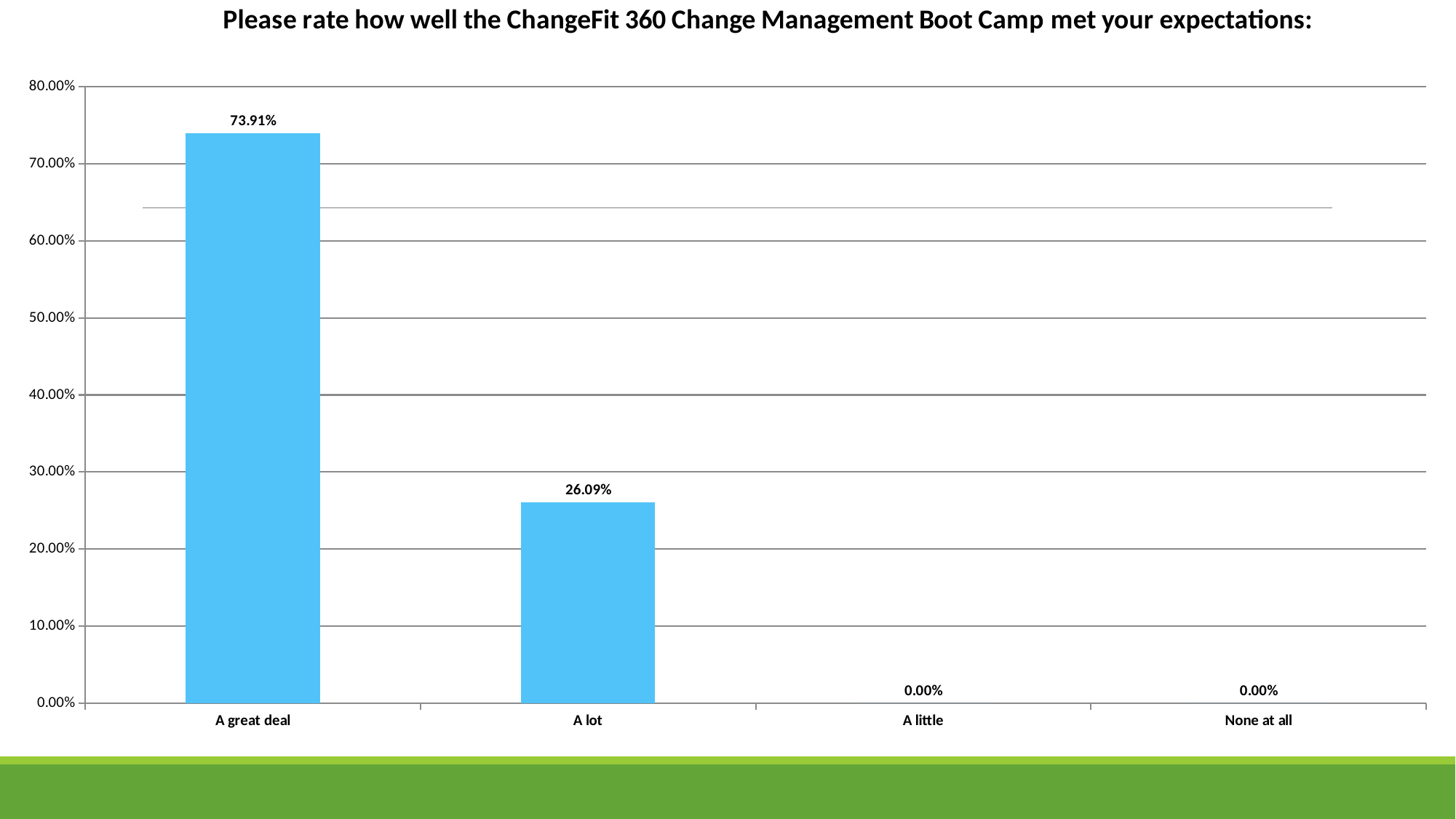
What is the value for "None at all"? 0.00% Which is larger, the value for "A lot" or the value for "A little"? A lot What is the value for "A lot"? 26.09% How many categories are shown on the x axis? 4 What is the difference between the values for "A great deal" and "A lot"? 47.82% Is the value for "A great deal" greater or less than 70.00%? greater What kind of chart is shown on the slide? bar chart What is the value for "A little"? 0.00% Which category has the highest value? A great deal Is the value for "A lot" greater or less than 30.00%? less What is the value for "A great deal"? 73.91% What is the title of the chart? Please rate how well the ChangeFit 360 Change Management Boot Camp met your expectations: